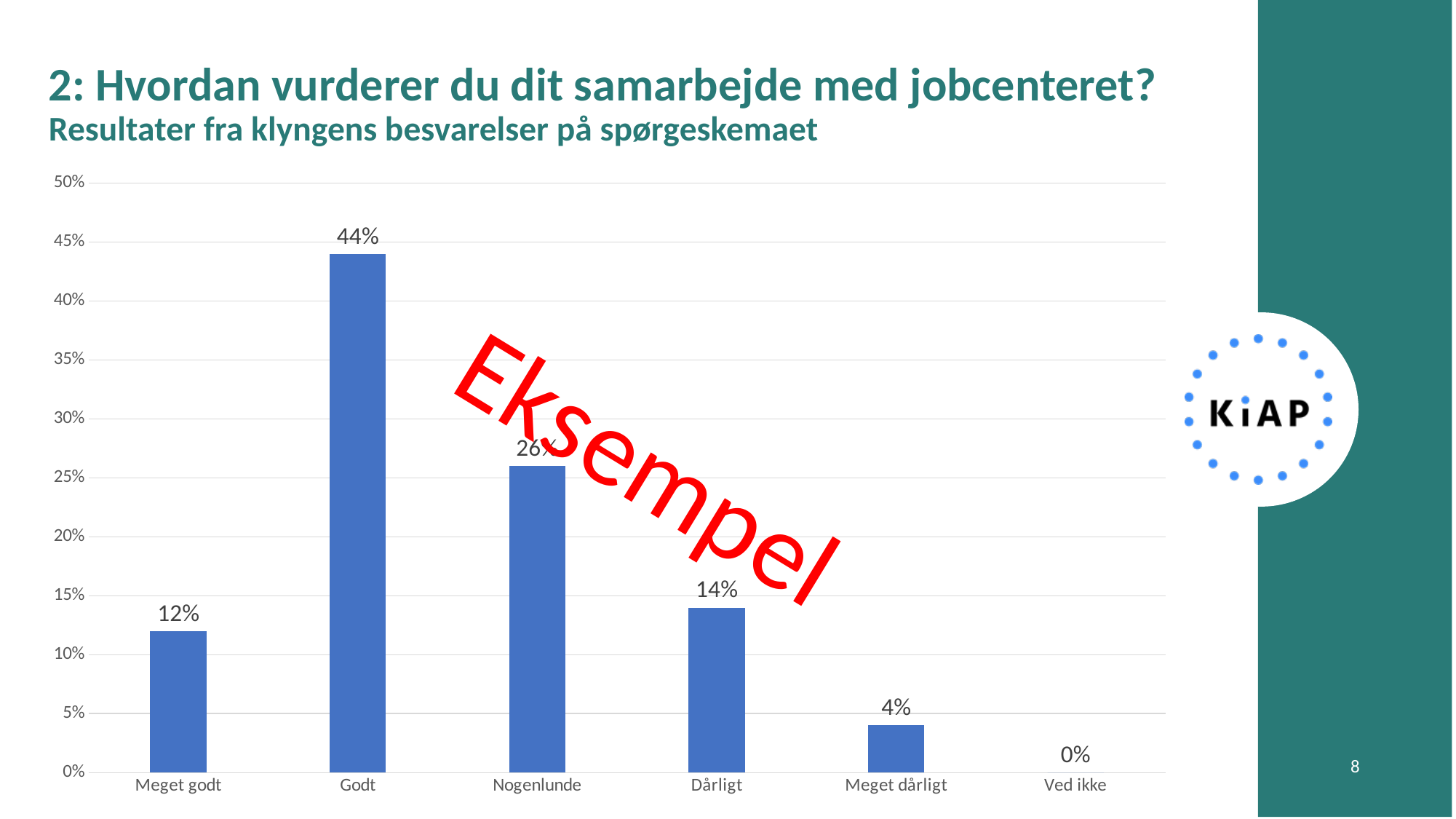
What kind of chart is shown on the slide? Bar chart What is the value for Ved ikke? 0% Is the value for Nogenlunde greater or less than 20%? greater What is the value for Godt? 44% What is the difference between the values for Godt and Meget godt? 32% Which is larger, the value for Dårligt or the value for Meget godt? Dårligt Which category has the lowest value? Ved ikke What is the value for Dårligt? 14% What is the value for Meget dårligt? 4% How many categories are shown on the x axis? 6 Which category has the highest value? Godt What is the value for Meget godt? 12%